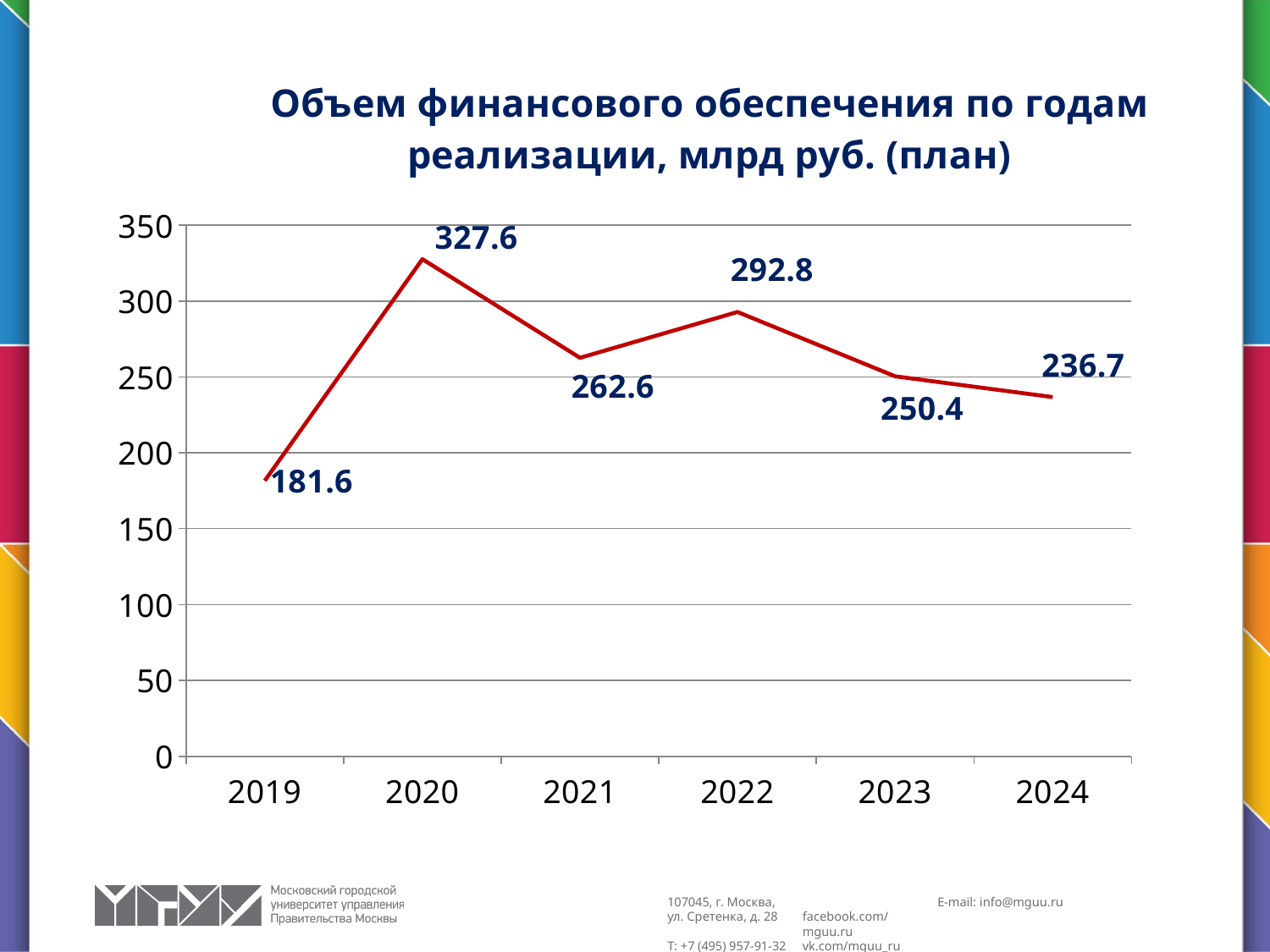
What is the difference between the values for 2022 and 2023? 42.4 What is the value for 2019? 181.6 Which is larger, the value for 2021 or the value for 2023? 2021 What is the value for 2024? 236.7 What is the difference between the values for 2020 and 2019? 146.0 What is the value for 2020? 327.6 How many years are plotted on the chart? 6 Which year has the lowest value? 2019 Which year has the highest value? 2020 Is the value for 2023 greater or less than 300? less What kind of chart is shown on the slide? line chart What is the value for 2022? 292.8